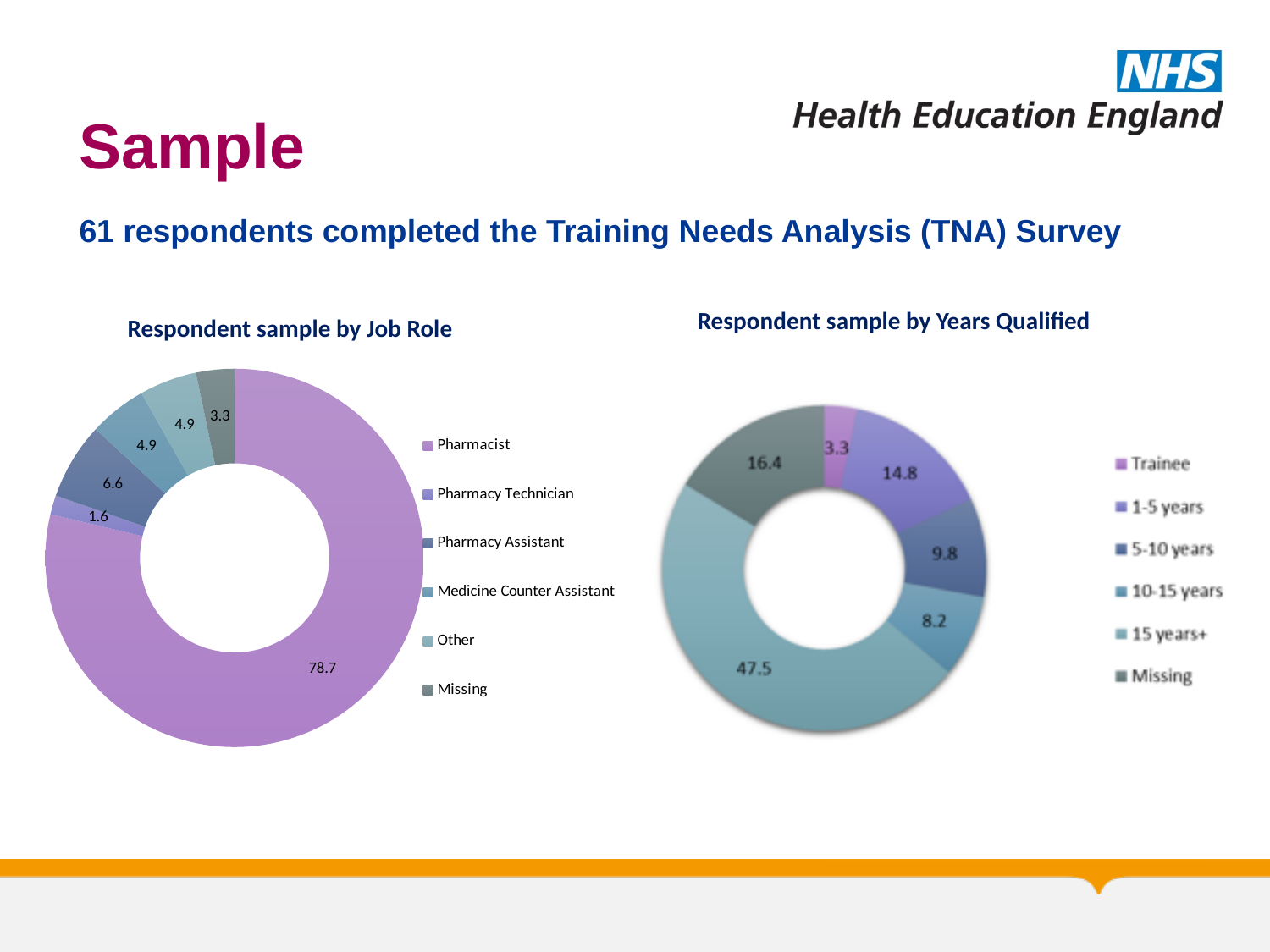
In the 'Respondent sample by Job Role' chart, what value is shown for Pharmacy Assistant? 6.6 In the 'Respondent sample by Job Role' chart, which category has the smallest value? Pharmacy Technician In the 'Respondent sample by Years Qualified' chart, which category has the largest value? 15 years+ In the 'Respondent sample by Job Role' chart, what is the difference between the Pharmacist value and the Pharmacy Assistant value? 72.1 In the 'Respondent sample by Years Qualified' chart, what value is shown for 15 years+? 47.5 In the 'Respondent sample by Years Qualified' chart, what value is shown for 1-5 years? 14.8 In the 'Respondent sample by Years Qualified' chart, which category has the smallest value? Trainee In the 'Respondent sample by Years Qualified' chart, what is the difference between the Missing value and the Trainee value? 13.1 In the 'Respondent sample by Job Role' chart, what value is shown for Pharmacist? 78.7 In the 'Respondent sample by Years Qualified' chart, which is larger: the value for 5-10 years or the value for 10-15 years? 5-10 years In the 'Respondent sample by Job Role' chart, how many categories does the legend list? 6 What type of chart is the 'Respondent sample by Years Qualified' chart? Doughnut chart